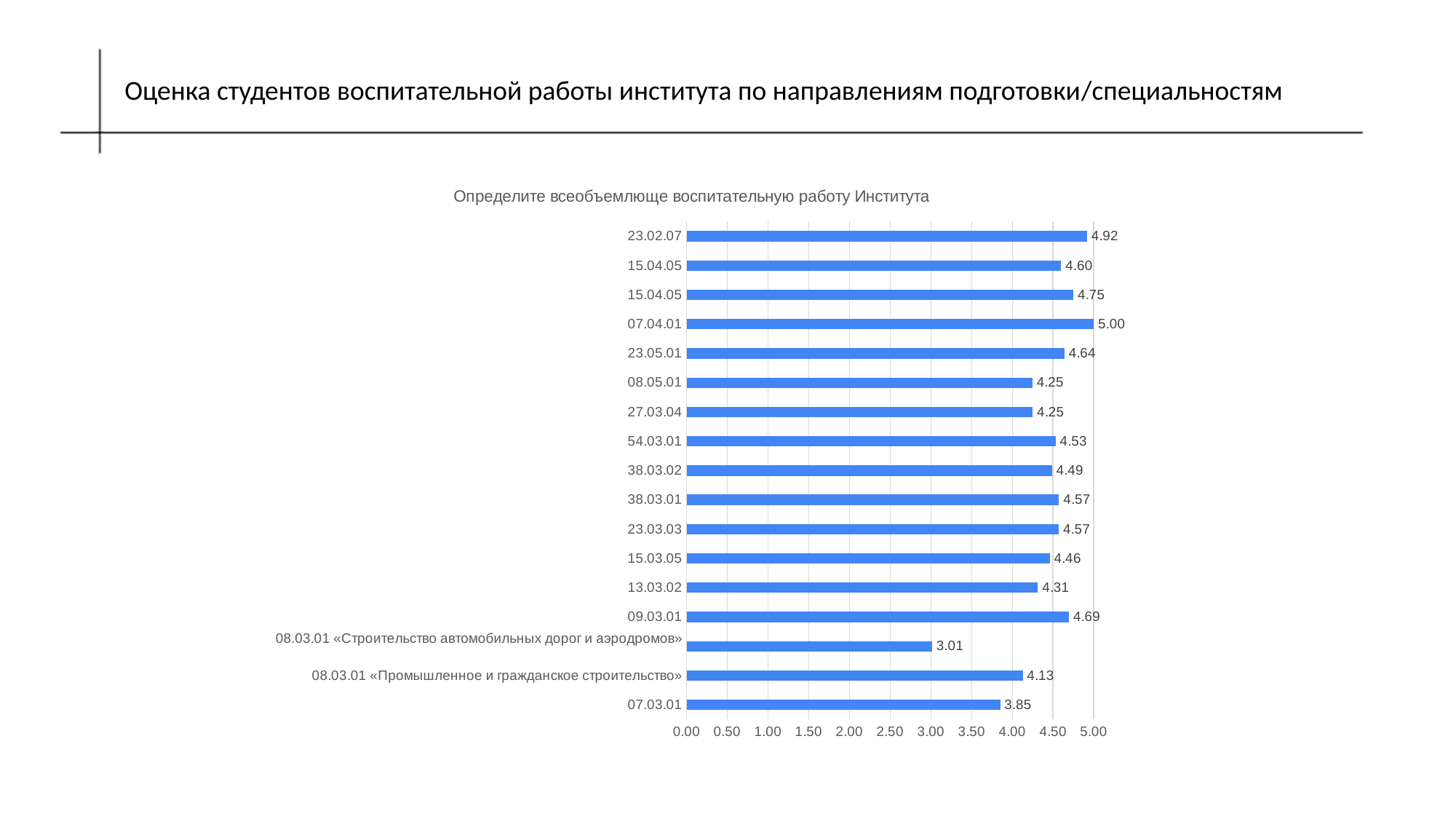
What is the difference between the values for 07.04.01 and 07.03.01? 1.15 Which category has the highest value? 07.04.01 Which category has the lowest value? 08.03.01 «Строительство автомобильных дорог и аэродромов» What is the value for 13.03.02? 4.31 Which has a larger value, 23.05.01 or 08.05.01? 23.05.01 What is the value for 08.03.01 «Промышленное и гражданское строительство»? 4.13 What kind of chart is shown on the slide? Bar chart Is the value for 08.03.01 «Строительство автомобильных дорог и аэродромов» greater or less than 3.50? less What is the difference between the values for 09.03.01 and 13.03.02? 0.38 What is the value for 23.02.07? 4.92 How many categories are shown in the chart? 17 What is the value for 07.03.01? 3.85